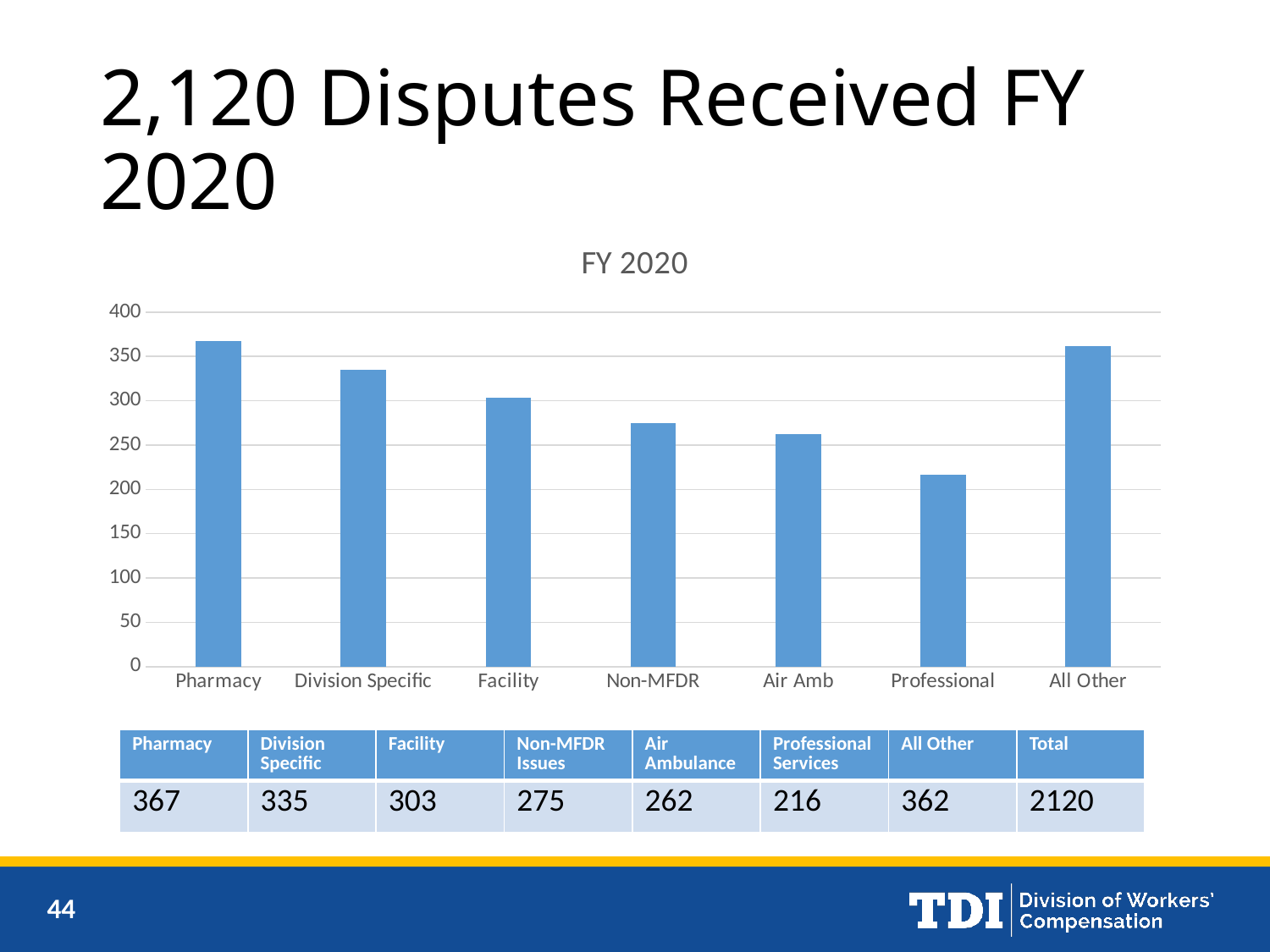
What is the title of the chart? FY 2020 Which is larger, the value for Facility or the value for Air Amb? Facility How many categories are shown on the x axis of the chart? 7 What is the value for Pharmacy in the FY 2020 chart? 367 What type of chart is shown on the slide? bar chart Which category has the lowest value in the FY 2020 chart? Professional Which category has the highest value in the FY 2020 chart? Pharmacy What is the difference between the values for Division Specific and Facility? 32 Is the value for All Other greater or less than 350? greater What is the difference between the values for Pharmacy and Professional? 151 What is the value for Professional in the FY 2020 chart? 216 What is the value for Non-MFDR in the FY 2020 chart? 275